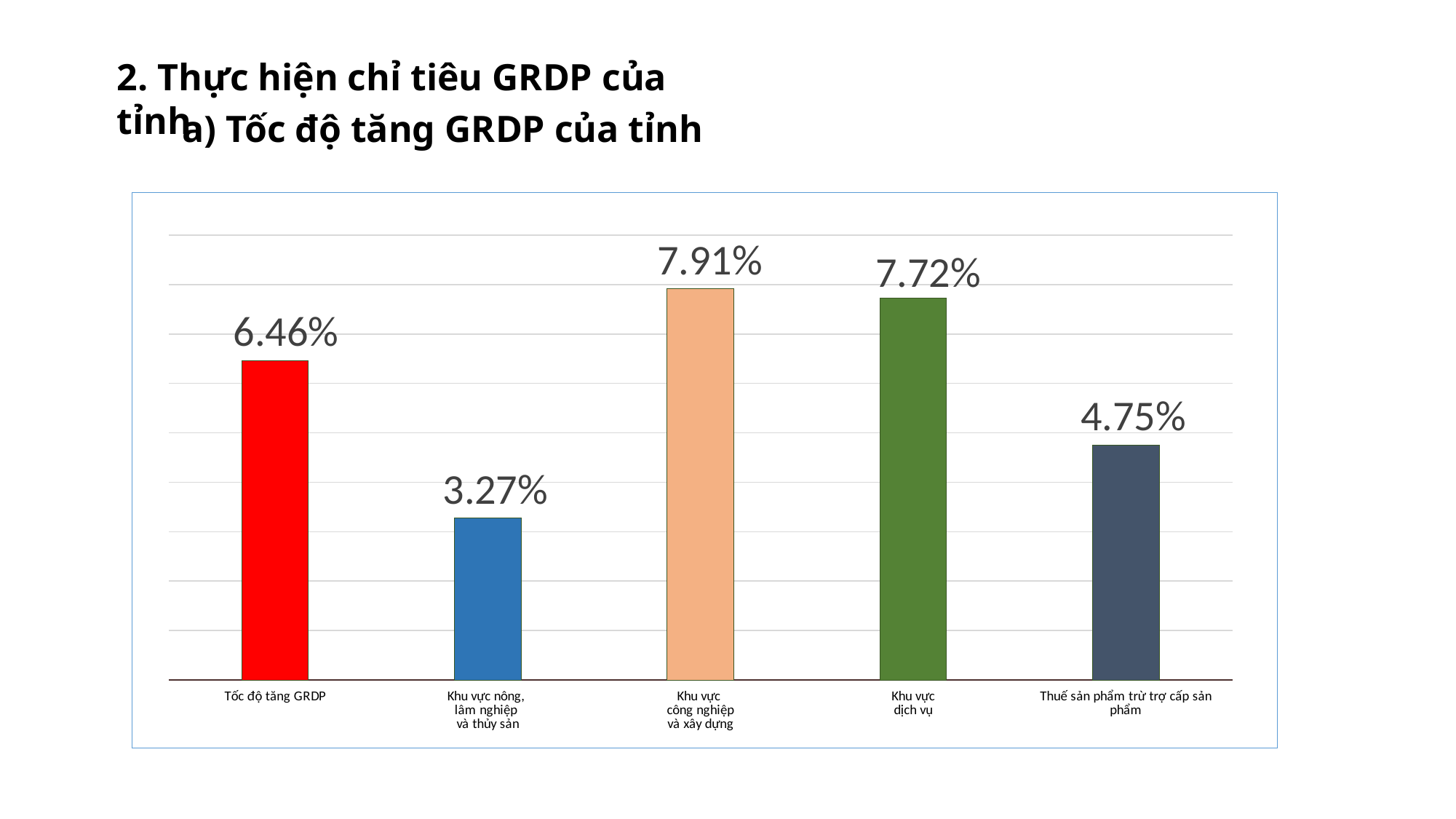
What kind of chart is shown on the slide? Bar chart How many categories are shown in the chart? 5 What is the difference between the values for Tốc độ tăng GRDP and Khu vực nông, lâm nghiệp và thủy sản? 3.19% What colour is the bar for Tốc độ tăng GRDP? Red What is the value for Khu vực công nghiệp và xây dựng? 7.91% What is the value for Khu vực nông, lâm nghiệp và thủy sản? 3.27% Which category has the highest value? Khu vực công nghiệp và xây dựng What is the value for Thuế sản phẩm trừ trợ cấp sản phẩm? 4.75% What is the value for Tốc độ tăng GRDP? 6.46% Which category has the lowest value? Khu vực nông, lâm nghiệp và thủy sản Which is larger, the value for Khu vực dịch vụ or the value for Thuế sản phẩm trừ trợ cấp sản phẩm? Khu vực dịch vụ What is the difference between the values for Khu vực công nghiệp và xây dựng and Khu vực dịch vụ? 0.19%